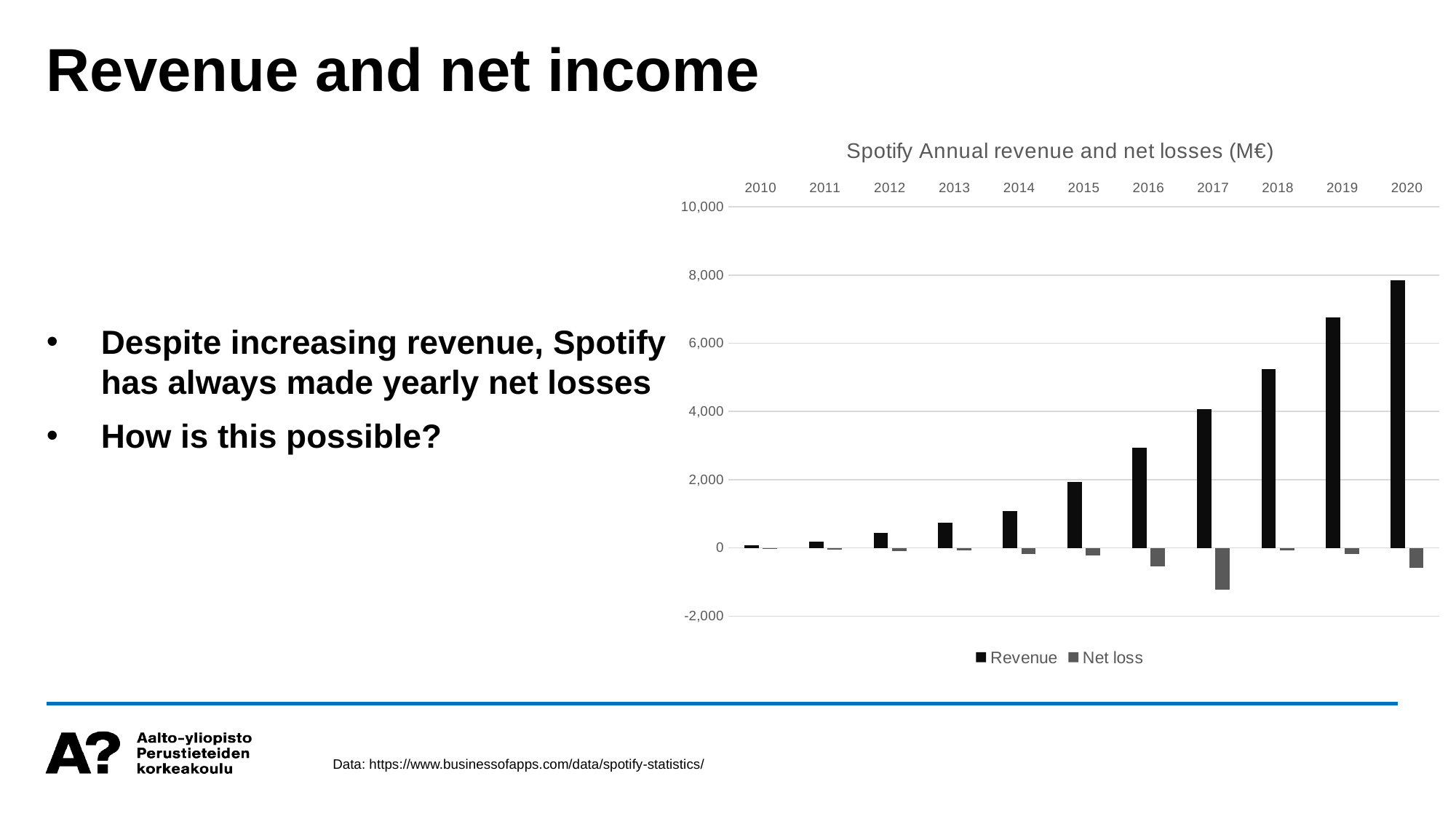
How many series does the legend list? 2 Is the Revenue value for 2018 greater or less than 4,000? greater Which year has the largest Net loss (the longest bar below zero)? 2017 Which is larger, the Revenue for 2019 or the Revenue for 2016? 2019 How many years are shown on the x axis of the chart? 11 Which year has the lowest Revenue? 2010 Which year has the highest Revenue? 2020 What kind of chart is shown on the slide? bar chart What is the title of the chart? Spotify Annual revenue and net losses (M€) Is the Revenue value for 2020 greater or less than 6,000? greater Does Revenue rise or fall from 2010 to 2020? rise Is the Revenue value for 2014 greater or less than 2,000? less